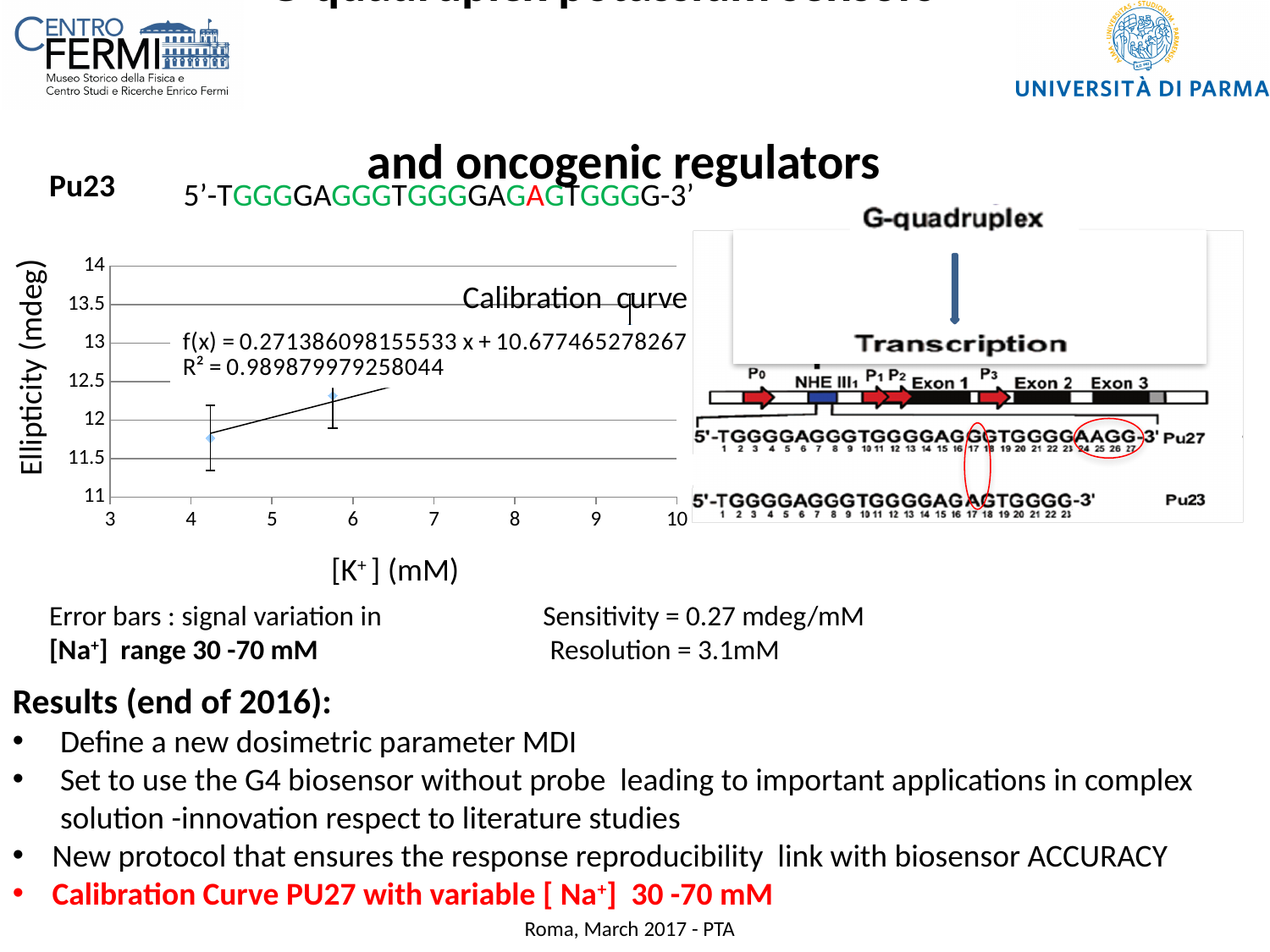
What is the trendline equation printed on the Calibration curve chart? f(x) = 0.271386098155533 x + 10.677465278267 What is the label of the y axis of the Calibration curve chart? Ellipticity (mdeg) In the Calibration curve chart, is the ellipticity of the data point near [K+] = 4 mM greater or less than 11.5? greater What is the R² value printed on the Calibration curve chart? 0.989879979258044 What is the highest tick value shown on the y axis of the Calibration curve chart? 14 In the Calibration curve chart, do the plotted values rise or fall as [K+] increases? rise In the Calibration curve chart, is the ellipticity of the data point near [K+] = 4 mM greater or less than 12? less In the Calibration curve chart, is the ellipticity of the data point near [K+] = 6 mM greater or less than 12? greater What kind of chart is the Calibration curve chart? scatter chart What is the title of the chart on the left of the slide? Calibration curve What is the lowest tick value shown on the x axis of the Calibration curve chart? 3 What is the slope of the trendline shown on the Calibration curve chart? 0.271386098155533